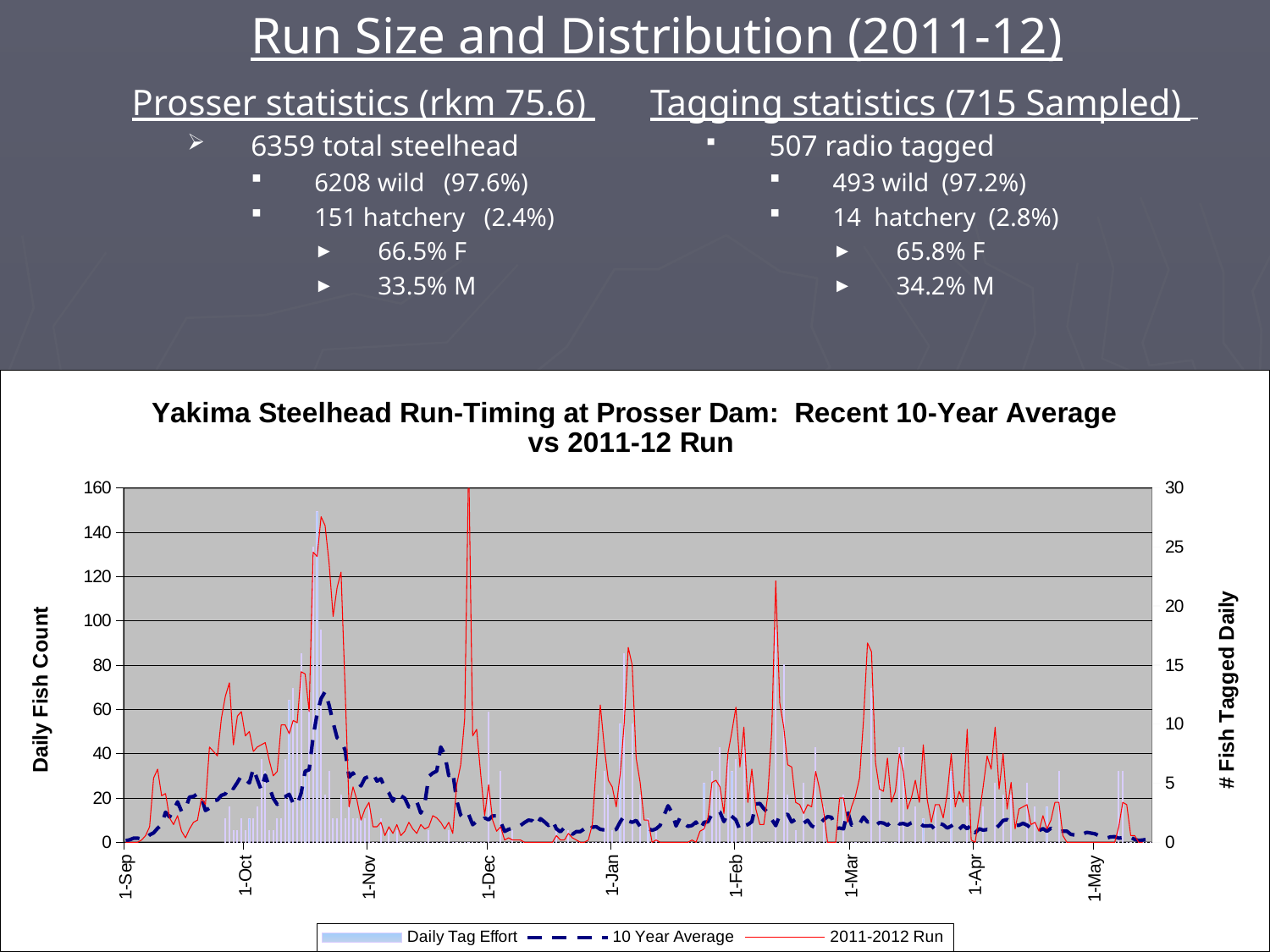
What is the label of the right vertical axis of the chart? # Fish Tagged Daily What is the maximum value shown on the left vertical axis of the chart? 160 How many month labels are shown along the x axis of the chart? 9 Which series in the chart is drawn as a dashed line? 10 Year Average Is the highest peak of the 2011-2012 Run line greater or less than 140 on the left axis? greater Which series reaches a higher peak value in the chart, the 2011-2012 Run or the 10 Year Average? 2011-2012 Run Is the highest peak of the 10 Year Average line greater or less than 40 on the left axis? greater What is the maximum value shown on the right vertical axis of the chart? 30 What is the label of the left vertical axis of the chart? Daily Fish Count What kind of chart is shown on the slide? Combined bar and line chart What is the title of the chart on the slide? Yakima Steelhead Run-Timing at Prosser Dam: Recent 10-Year Average vs 2011-12 Run How many series does the chart legend list? 3